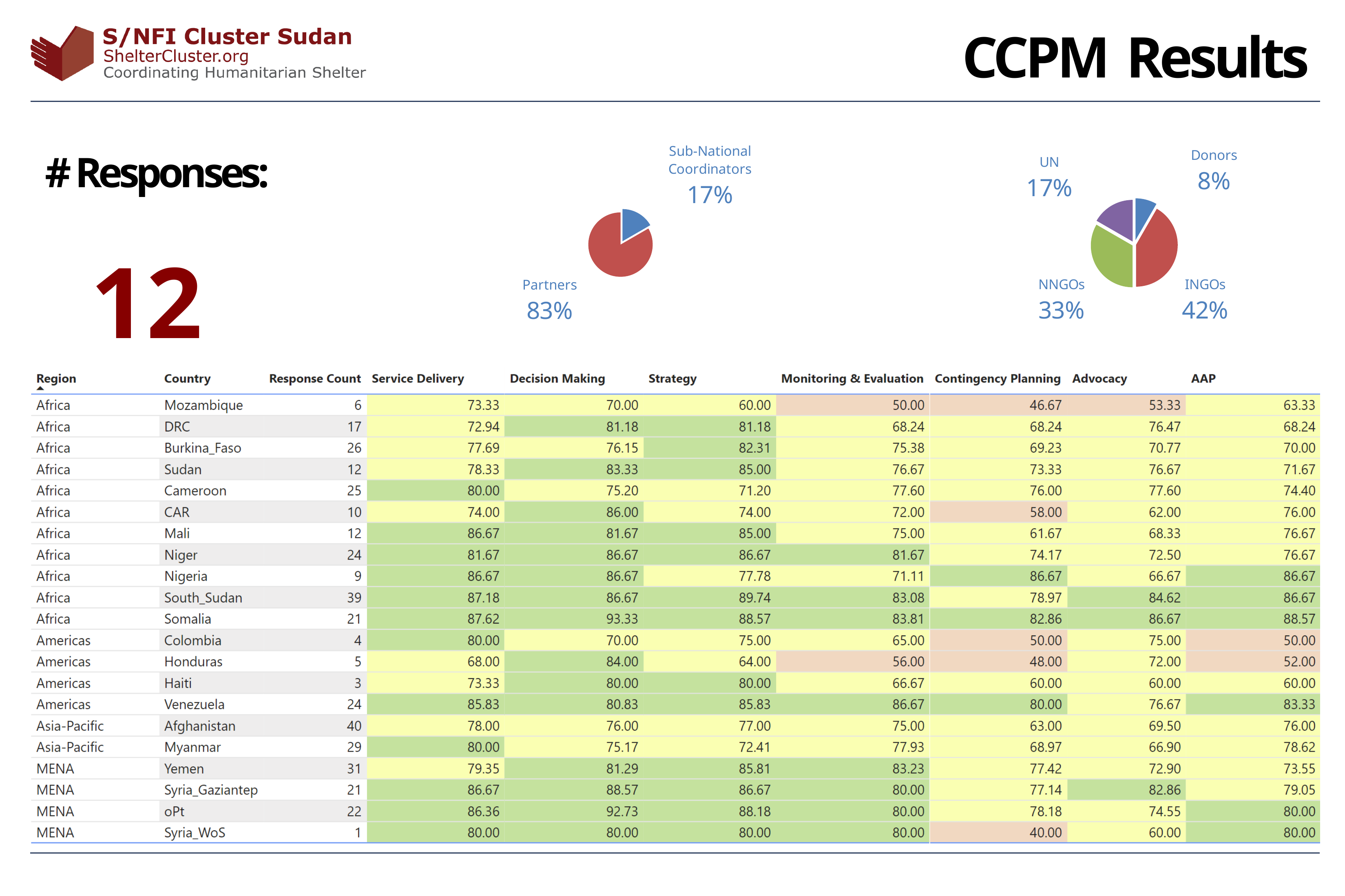
How many slices does the left pie chart have? 2 In the right pie chart, what share do NNGOs have? 33% In the right pie chart, what share do Donors have? 8% In the left pie chart, what share do Partners have? 83% What kind of chart is the left chart showing Partners and Sub-National Coordinators? pie chart In the right pie chart, which category has the largest share? INGOs How many slices does the right pie chart have? 4 In the right pie chart, which is larger, the UN share or the NNGOs share? NNGOs In the right pie chart, what is the difference between the INGOs share and the NNGOs share? 9% In the right pie chart, which category has the smallest share? Donors